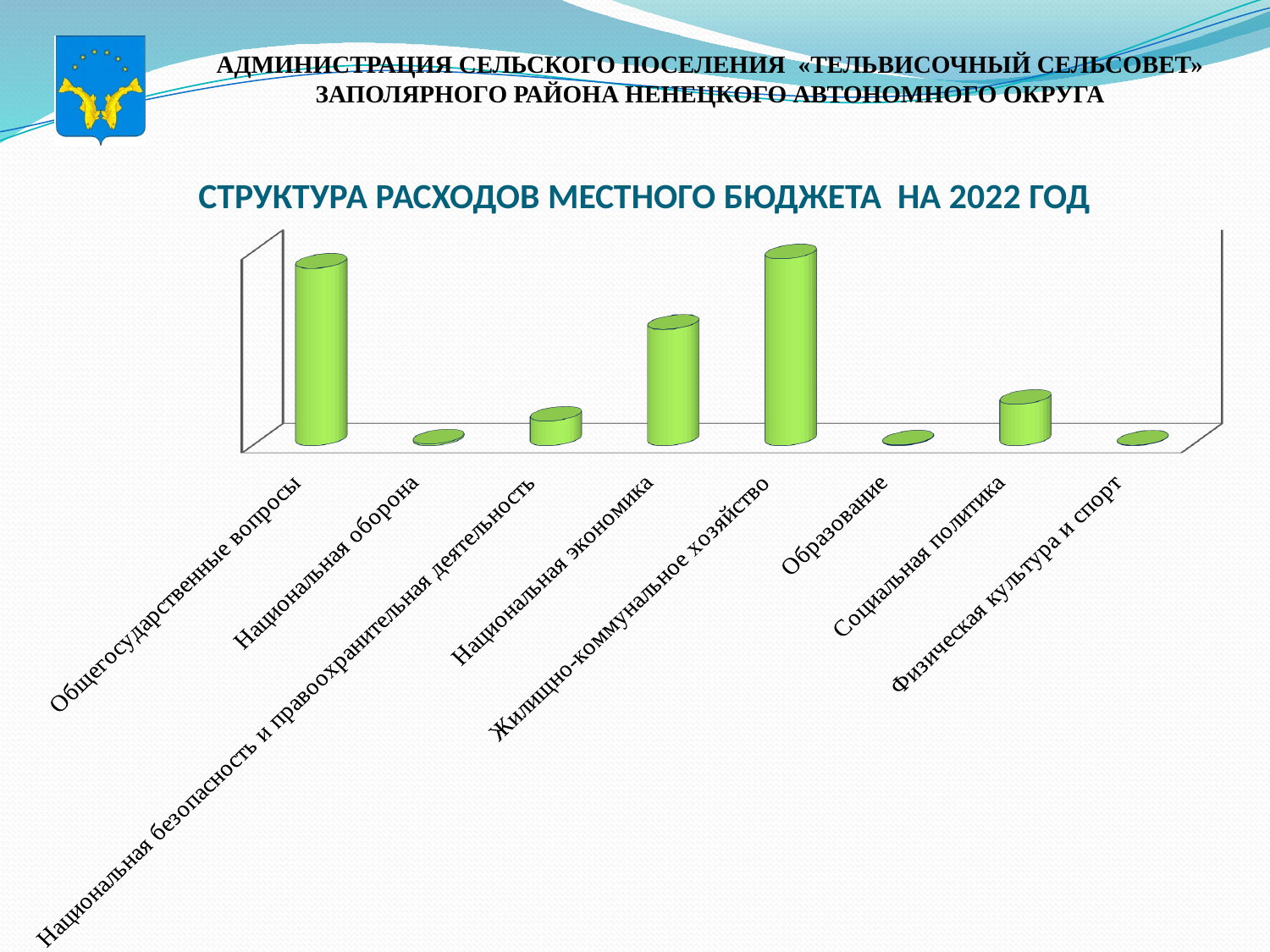
What kind of chart is shown on the slide? bar chart How many expenditure categories are shown in the chart? 8 Which bar is taller: Общегосударственные вопросы or Национальная безопасность и правоохранительная деятельность? Общегосударственные вопросы Which bar is taller: Национальная экономика or Образование? Национальная экономика Which bar is taller: Жилищно-коммунальное хозяйство or Национальная экономика? Жилищно-коммунальное хозяйство Which category has the tallest bar in the chart? Жилищно-коммунальное хозяйство What colour are the bars in the chart? green What is the title of the chart? СТРУКТУРА РАСХОДОВ МЕСТНОГО БЮДЖЕТА НА 2022 ГОД